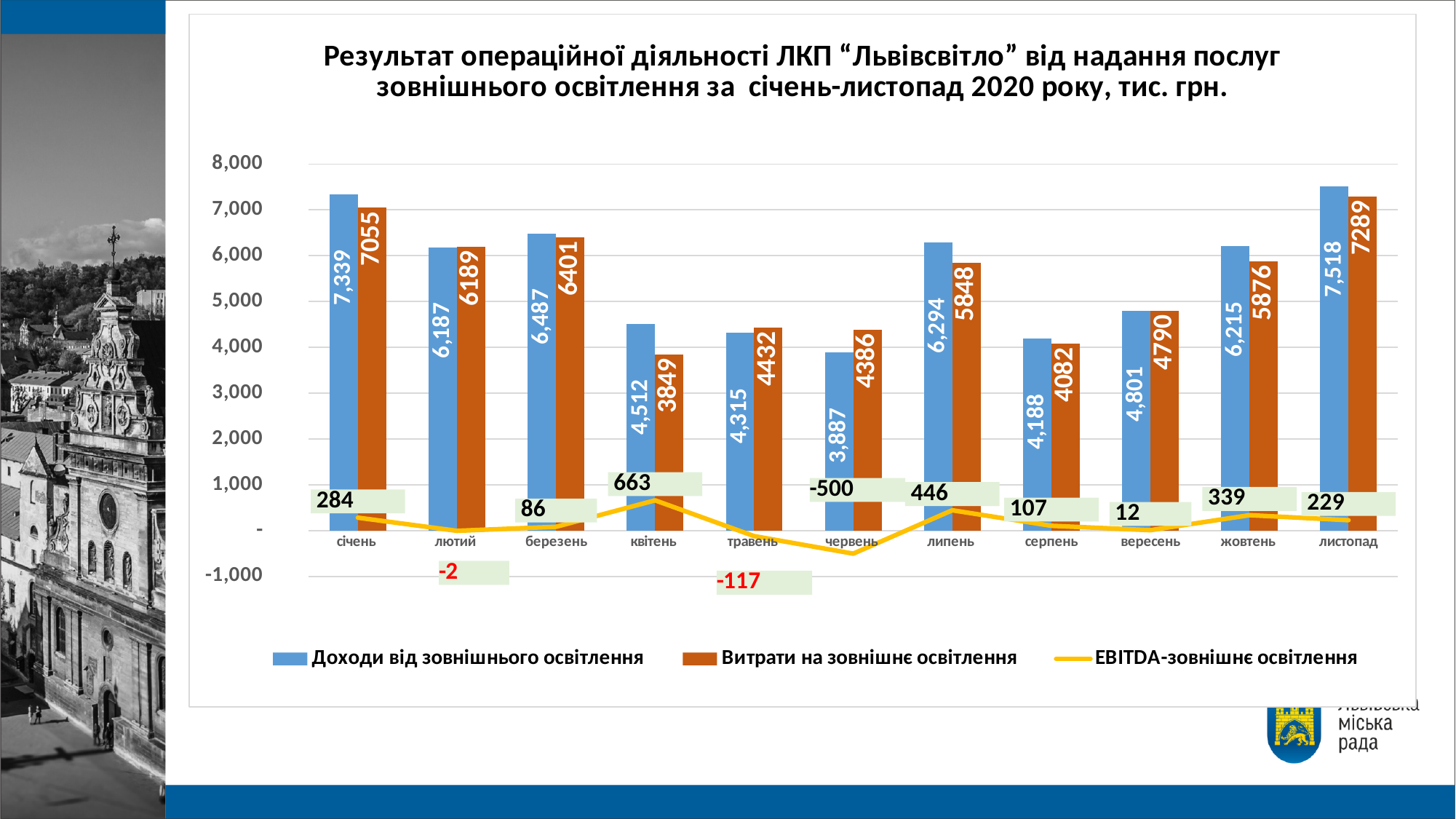
In which month is the EBITDA value the lowest? червень In which month is the income from outdoor lighting the lowest? червень What is the difference between income (7,339) and expenses (7055) in січень? 284 What is the EBITDA value for квітень? 663 How many series does the legend list? 3 Does the income from outdoor lighting rise or fall from квітень to червень? Fall In which month is the income from outdoor lighting the highest? листопад How many months are shown on the x axis? 11 What kind of chart is this? Bar chart with a line series What are the expenses on outdoor lighting (Витрати на зовнішнє освітлення) for липень? 5848 What is the income from outdoor lighting (Доходи від зовнішнього освітлення) for листопад? 7,518 In травень, which is larger: income from outdoor lighting or expenses on outdoor lighting? Expenses on outdoor lighting (4432)